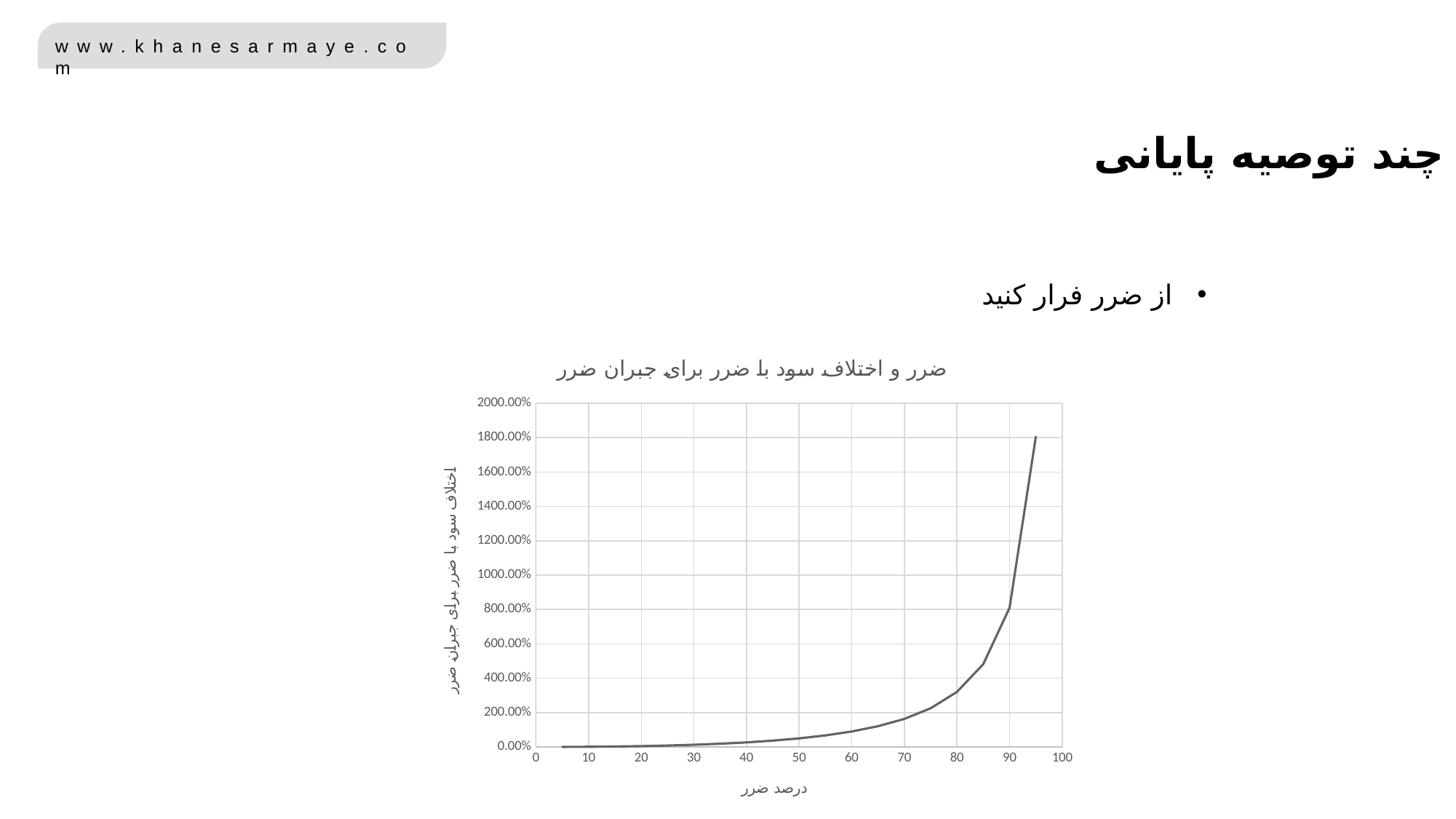
Is the value of the line at a loss of 50 greater or less than 200.00%? less Is the value of the line at a loss of 80 greater or less than 600.00%? less Is the value of the line at a loss of 80 greater or less than 200.00%? greater What is the label of the x axis of the chart? درصد ضرر Which has the smaller value on the line: a loss of 30 or a loss of 70? 30 Does the plotted line rise or fall as the loss percentage (درصد ضرر) increases along the x axis? rises Which has the larger value on the line: a loss of 90 or a loss of 80? 90 What is the title of the chart? ضرر و اختلاف سود با ضرر برای جبران ضرر What kind of chart is shown on the slide? line chart